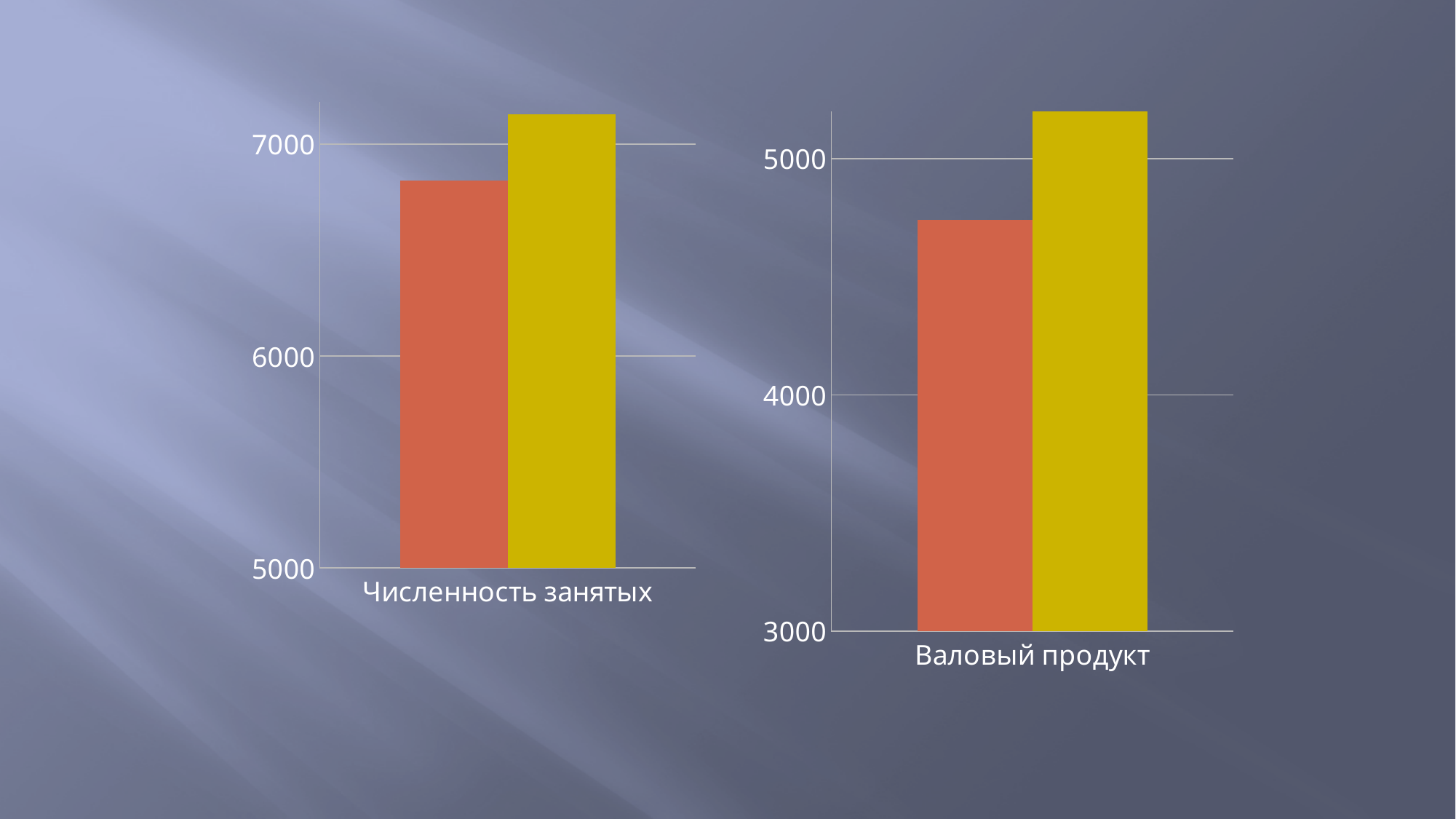
In the left chart ("Численность занятых"), how many bars are plotted? 2 In the left chart ("Численность занятых"), is the value of the orange bar greater or less than 7000? less In the left chart ("Численность занятых"), is the value of the yellow bar greater or less than 7000? greater In the right chart ("Валовый продукт"), how many bars are plotted? 2 In the right chart ("Валовый продукт"), is the value of the yellow bar greater or less than 5000? greater What kind of chart is the right chart labelled "Валовый продукт"? bar chart In the right chart ("Валовый продукт"), which bar is taller, the orange one or the yellow one? the yellow one In the left chart ("Численность занятых"), which bar is taller, the orange one or the yellow one? the yellow one What is the category label shown under the bars of the left chart? Численность занятых What kind of chart is the left chart labelled "Численность занятых"? bar chart